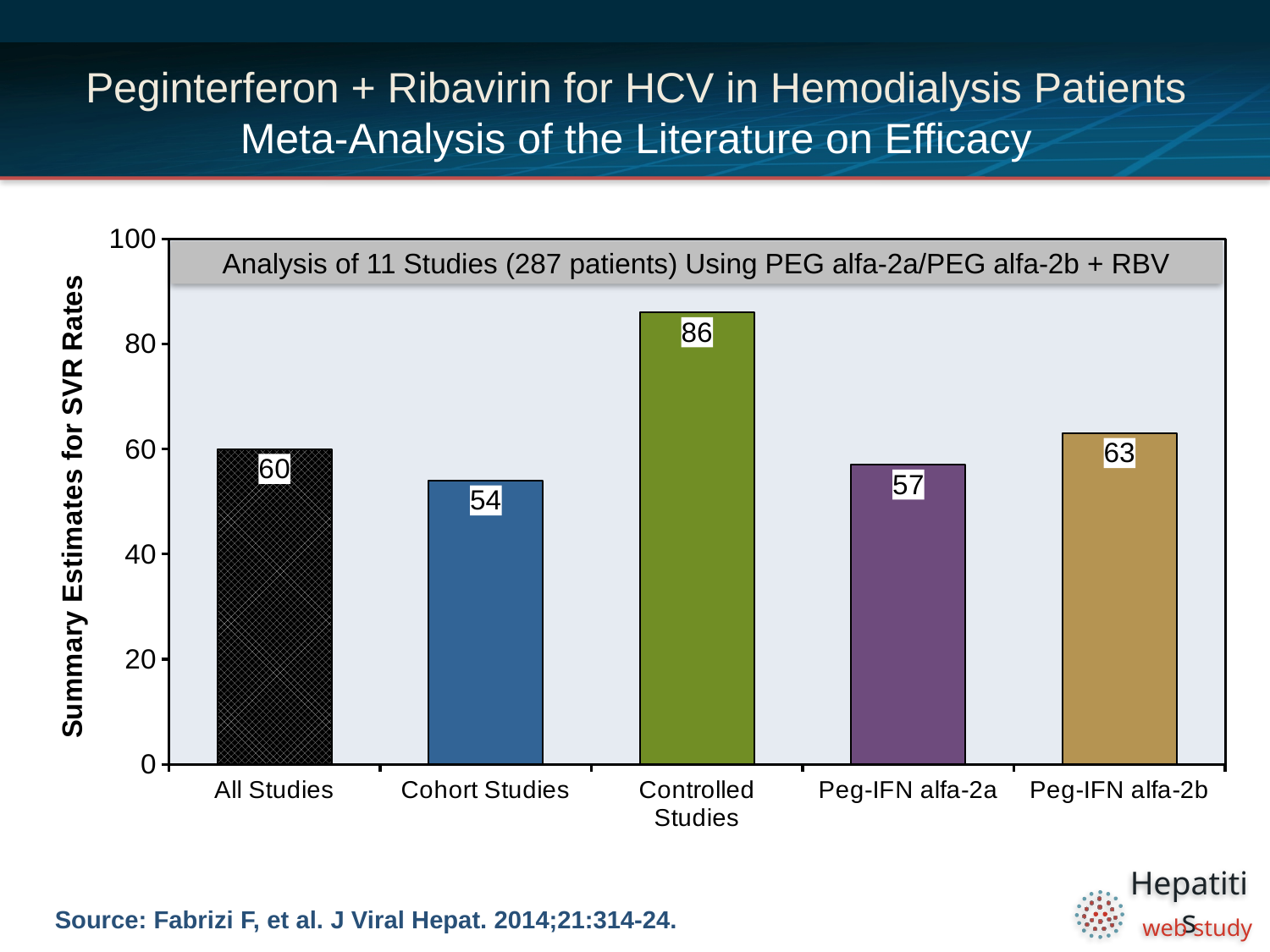
What is the summary estimate for SVR rate for Cohort Studies? 54 What is the summary estimate for SVR rate for Peg-IFN alfa-2b? 63 Which category has the lowest summary estimate for SVR rate? Cohort Studies Which category has the highest summary estimate for SVR rate? Controlled Studies What is the summary estimate for SVR rate for Controlled Studies? 86 Which has a higher SVR rate, All Studies or Peg-IFN alfa-2a? All Studies Is the value for Controlled Studies greater or less than 80? greater What is the difference between the SVR rate for Controlled Studies and for Cohort Studies? 32 How many categories are shown on the x axis of the chart? 5 What is the label of the y axis of the chart? Summary Estimates for SVR Rates What is the difference between the SVR rate for Peg-IFN alfa-2b and for Peg-IFN alfa-2a? 6 What kind of chart is shown on the slide? Bar chart